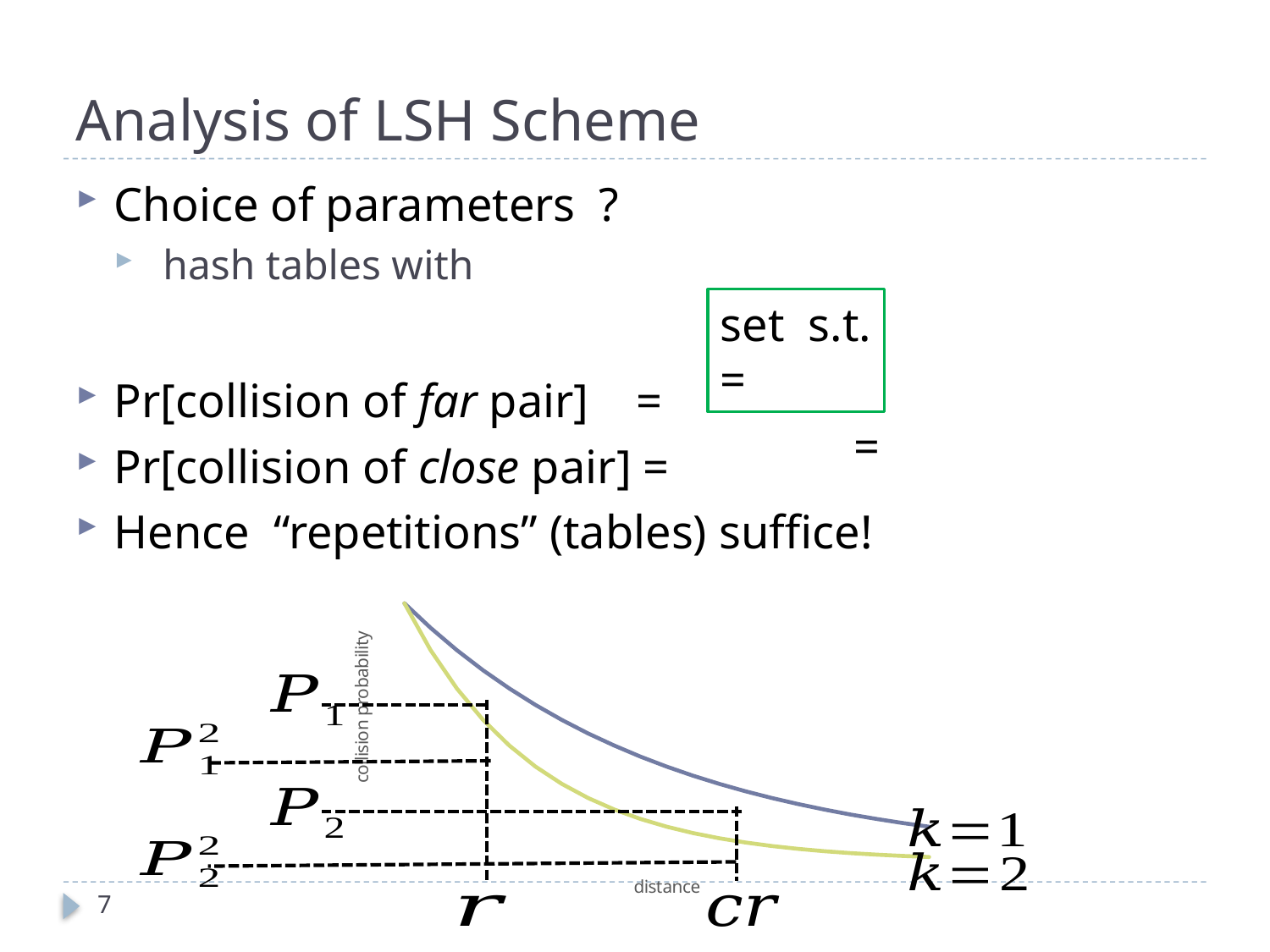
How many curves are plotted in the chart? 2 What kind of chart is shown at the bottom of the slide? line chart What is the label of the x axis of the chart? distance What is the label of the y axis of the chart? collision probability Which curve is higher at distance cr, k=1 or k=2? k=1 Which curve is lower at distance r, k=1 or k=2? k=2 Do the curves rise or fall as distance increases along the x axis? fall Which curve decreases faster with distance, k=1 or k=2? k=2 What are the two distance values marked on the x axis of the chart? r and cr